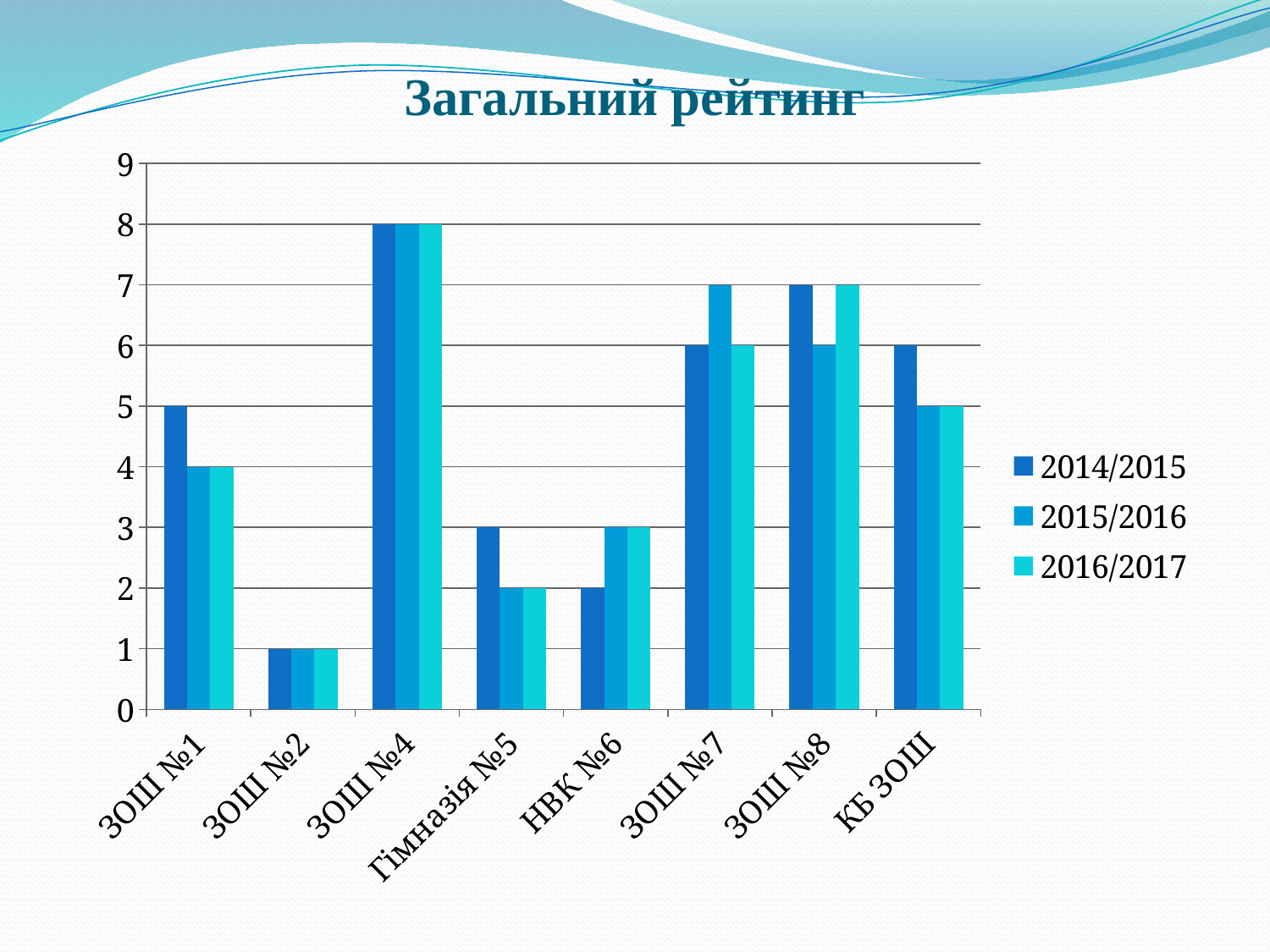
What is the value for ЗОШ №7 in 2015/2016? 7 What is the value for ЗОШ №4 in 2014/2015? 8 What type of chart is shown on the slide? bar chart How many schools (categories) are shown on the x axis? 8 What is the title of the chart? Загальний рейтинг What is the value for ЗОШ №1 in 2014/2015? 5 What is the difference between the 2014/2015 value for ЗОШ №8 and the 2014/2015 value for Гімназія №5? 4 Which school has the highest value in 2015/2016? ЗОШ №4 How many series does the legend list? 3 Which school has the lowest value in 2016/2017? ЗОШ №2 Is the value for НВК №6 in 2014/2015 greater or less than 4? less Which is larger for КБ ЗОШ: the 2014/2015 value or the 2016/2017 value? 2014/2015